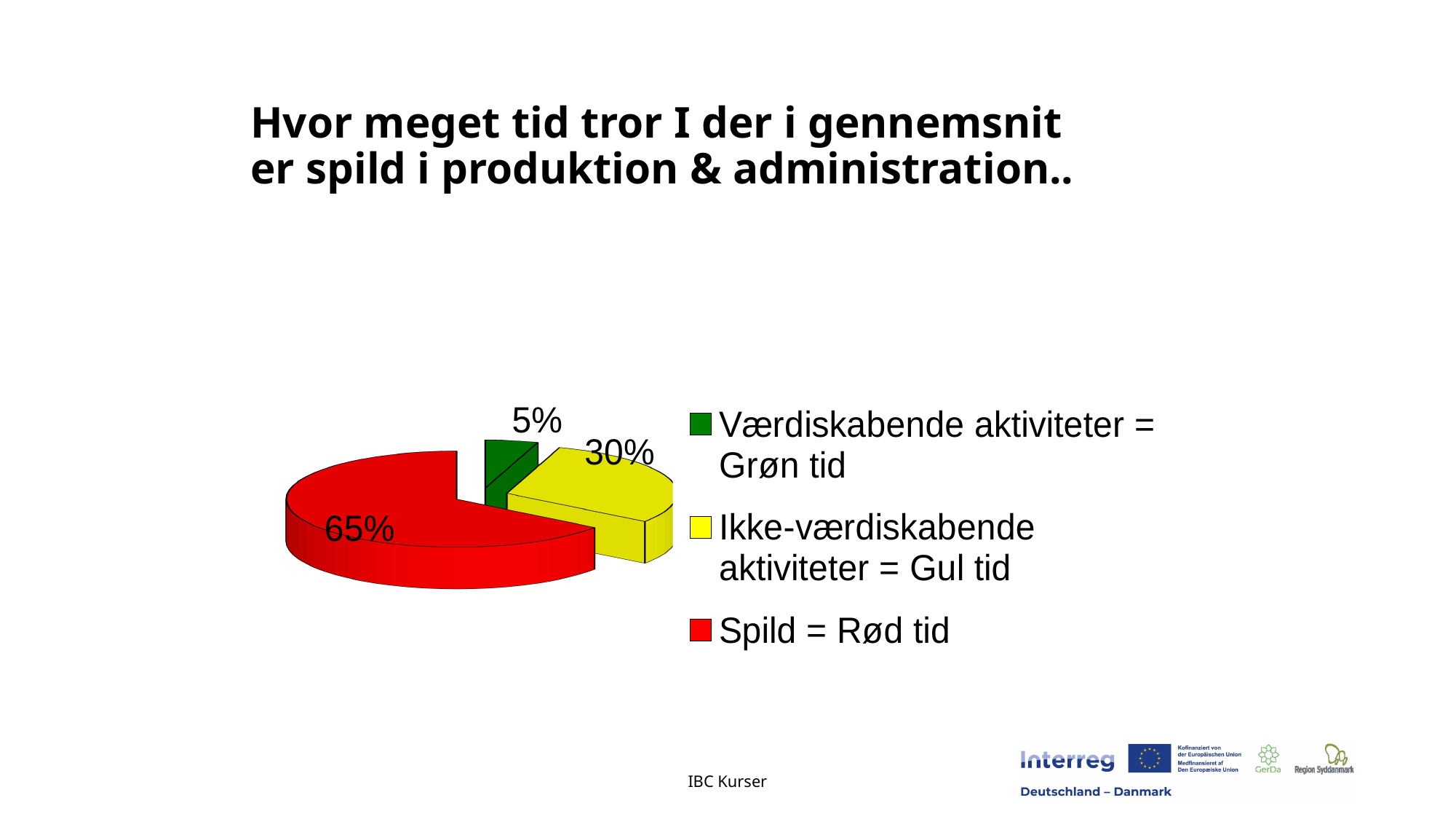
What is the difference in percentage points between the "Spild = Rød tid" slice and the "Ikke-værdiskabende aktiviteter = Gul tid" slice? 35 What is the difference in percentage points between the "Ikke-værdiskabende aktiviteter = Gul tid" slice and the "Værdiskabende aktiviteter = Grøn tid" slice? 25 What colour is the slice for "Spild = Rød tid"? red Which category has the largest slice of the pie? Spild = Rød tid Which is larger: the "Ikke-værdiskabende aktiviteter = Gul tid" slice or the "Værdiskabende aktiviteter = Grøn tid" slice? Ikke-værdiskabende aktiviteter = Gul tid What share of the pie is labelled "Spild = Rød tid"? 65% What share of the pie is labelled "Ikke-værdiskabende aktiviteter = Gul tid"? 30% What share of the pie is labelled "Værdiskabende aktiviteter = Grøn tid"? 5% How many slices does the pie chart have? 3 Which category has the smallest slice of the pie? Værdiskabende aktiviteter = Grøn tid What kind of chart is shown on the slide? pie chart How many entries does the legend list? 3